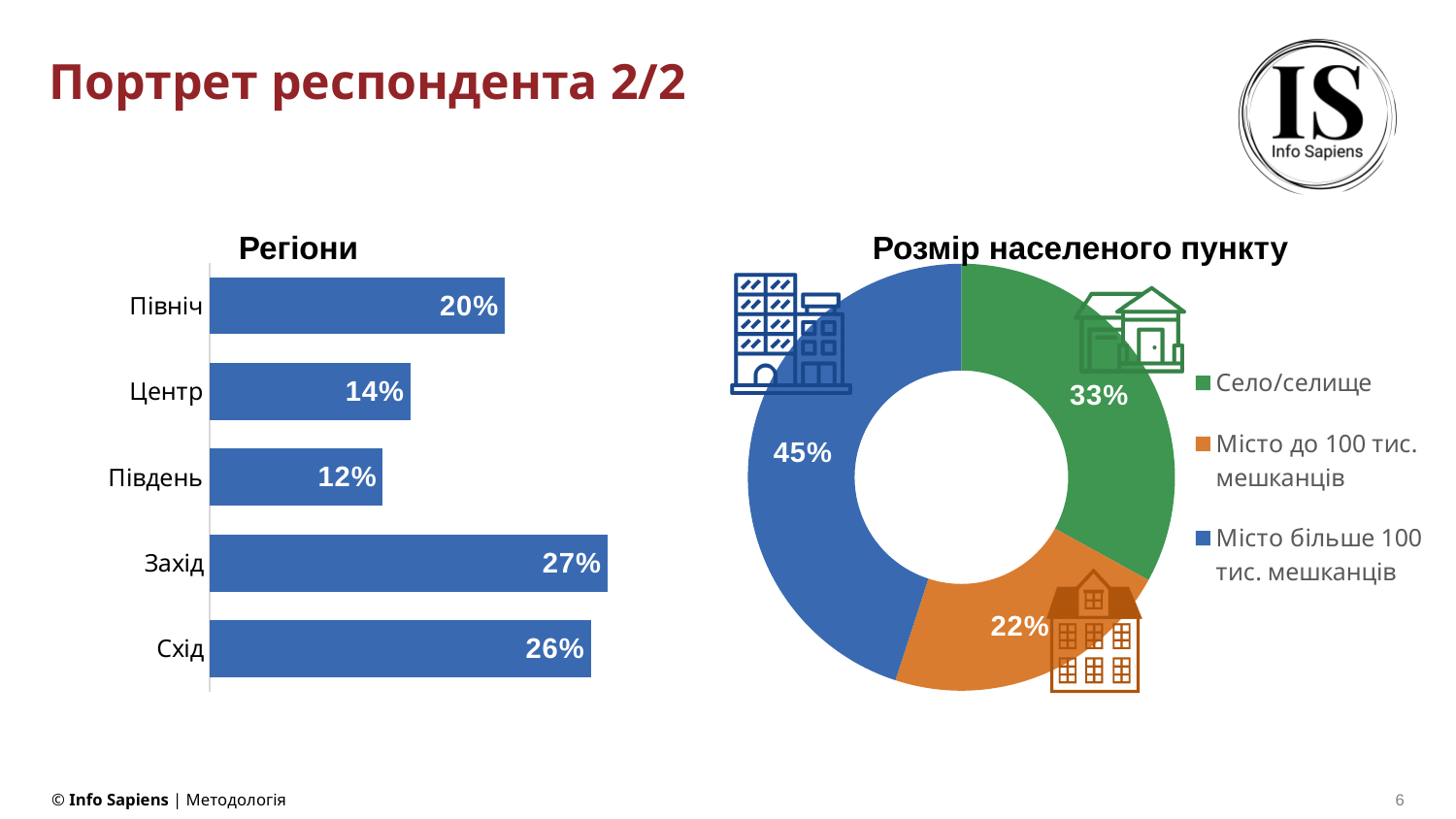
In the "Розмір населеного пункту" chart, which category has the largest share? Місто більше 100 тис. мешканців In the "Регіони" chart, which region has the highest value? Захід How many regions are shown in the "Регіони" chart? 5 In the "Регіони" chart, what is the value for Південь? 12% In the "Регіони" chart, what is the value for Північ? 20% In the "Регіони" chart, which region has the lowest value? Південь In the "Регіони" chart, what is the difference between the values for Захід and Центр? 13% In the "Розмір населеного пункту" chart, what colour is the Місто до 100 тис. мешканців slice? Orange In the "Розмір населеного пункту" chart, what share is Село/селище? 33% In the "Регіони" chart, which is larger: the value for Схід or the value for Північ? Схід How many entries does the legend of the "Розмір населеного пункту" chart list? 3 What kind of chart is the "Регіони" chart? Bar chart